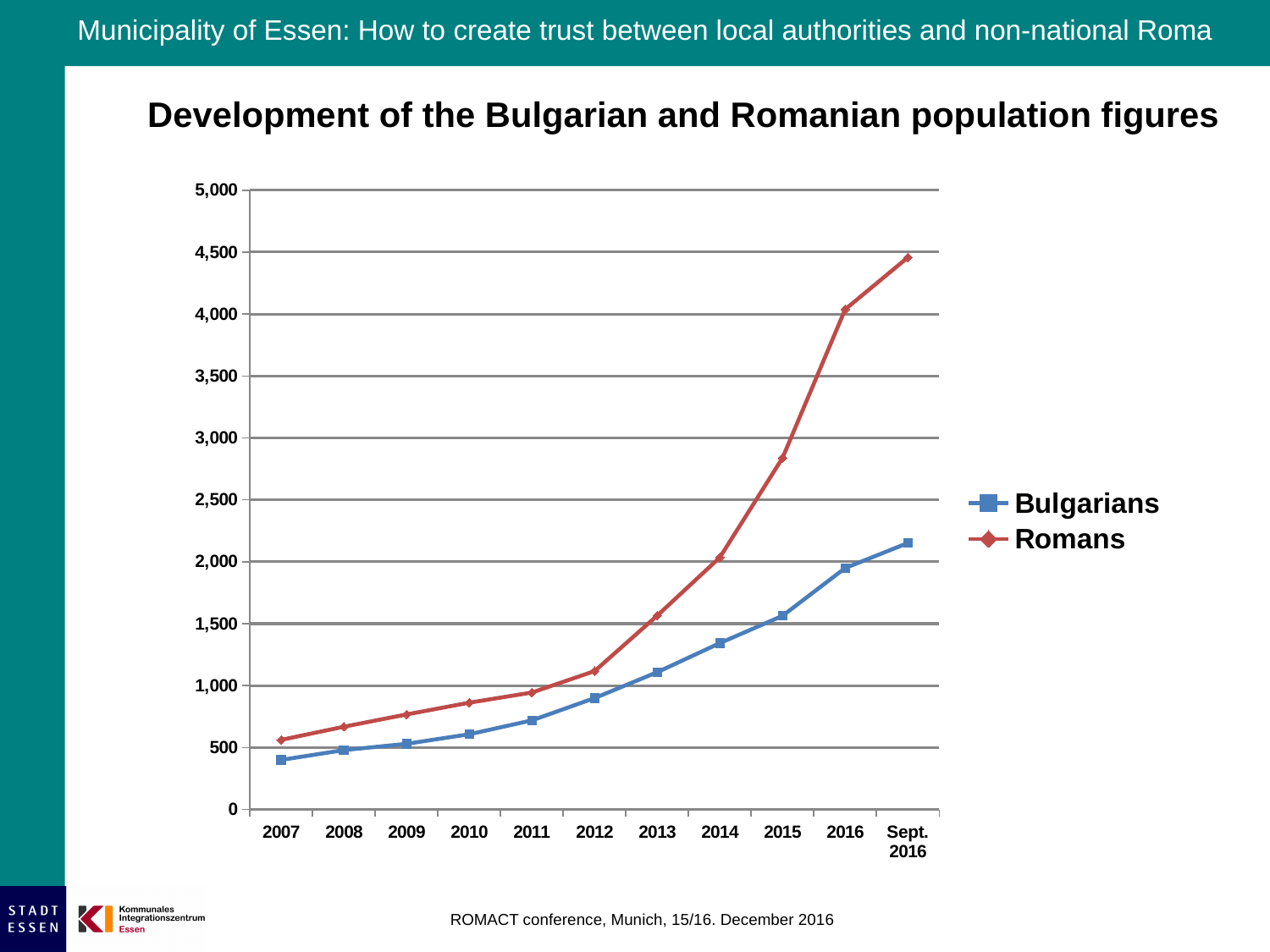
Do the Bulgarians values rise or fall from 2007 to Sept. 2016? Rise Is the value for Romans in 2015 greater or less than 2,500? greater What is the title of the chart? Development of the Bulgarian and Romanian population figures What kind of chart is shown on the slide? Line chart Is the value for Bulgarians in 2014 greater or less than 1,500? less Is the value for Bulgarians in 2007 greater or less than 500? less Which series has the higher value in Sept. 2016, Bulgarians or Romans? Romans At which time point is the Bulgarians series lowest? 2007 How many time points are plotted along the x axis? 11 How many series does the legend list? 2 At which time point is the Romans series highest? Sept. 2016